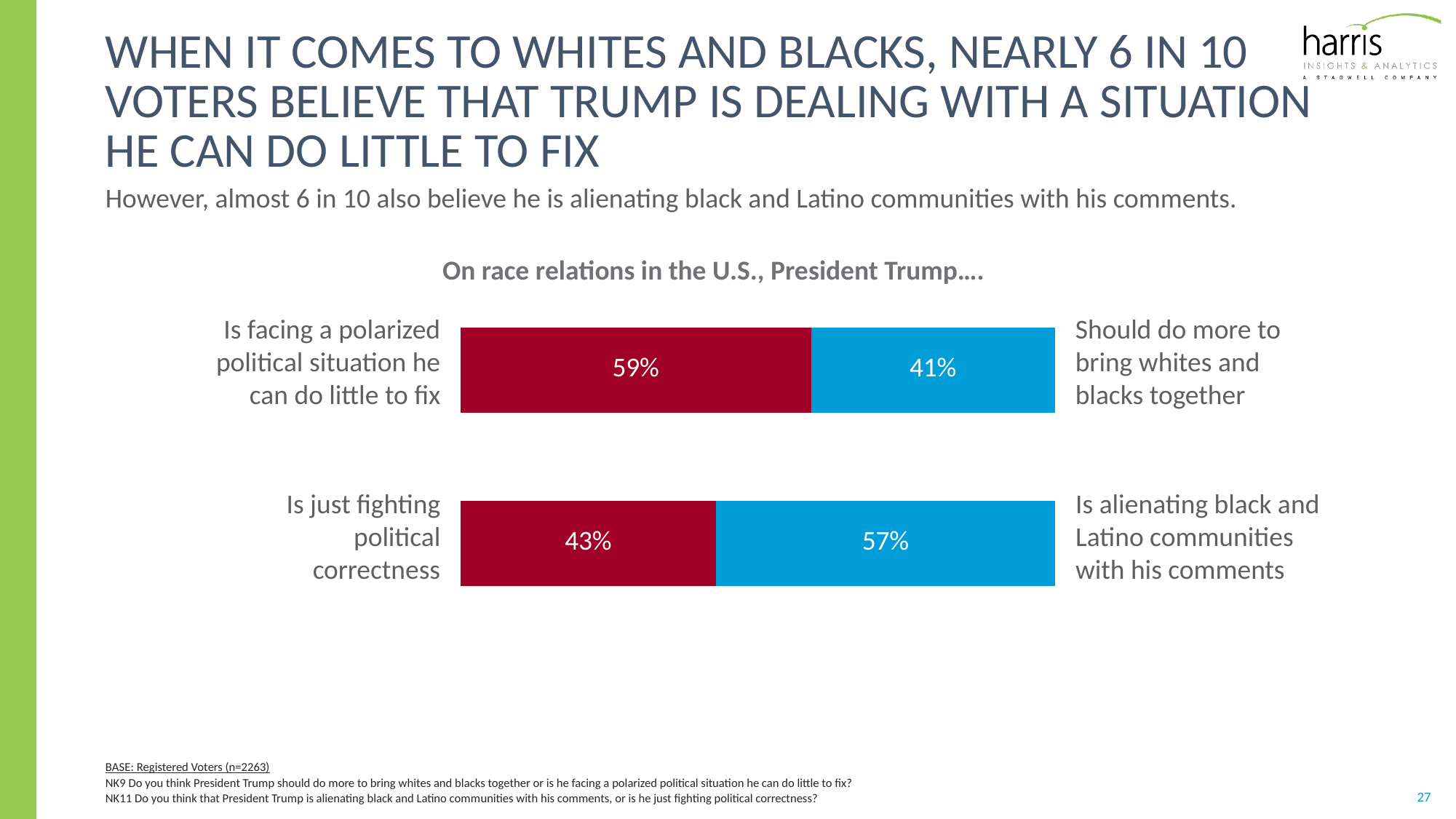
Which is larger: the share saying Trump is just fighting political correctness or the share saying he is alienating black and Latino communities with his comments? Is alienating black and Latino communities with his comments Which response has the lowest percentage on the chart? Should do more to bring whites and blacks together What percentage of voters say President Trump is alienating black and Latino communities with his comments? 57% What percentage of voters say President Trump is just fighting political correctness? 43% Which response has the highest percentage on the chart? Is facing a polarized political situation he can do little to fix What percentage of voters say President Trump is facing a polarized political situation he can do little to fix? 59% What percentage of voters say President Trump should do more to bring whites and blacks together? 41% What is the difference between the share saying Trump is alienating black and Latino communities and the share saying he is just fighting political correctness? 14 percentage points What type of chart is shown on the slide? Stacked bar chart What is the total of the two segments in the bar about fighting political correctness versus alienating black and Latino communities? 100% How many bars are shown on the chart? 2 What is the difference between the share saying Trump is facing a polarized political situation he can do little to fix and the share saying he should do more to bring whites and blacks together? 18 percentage points